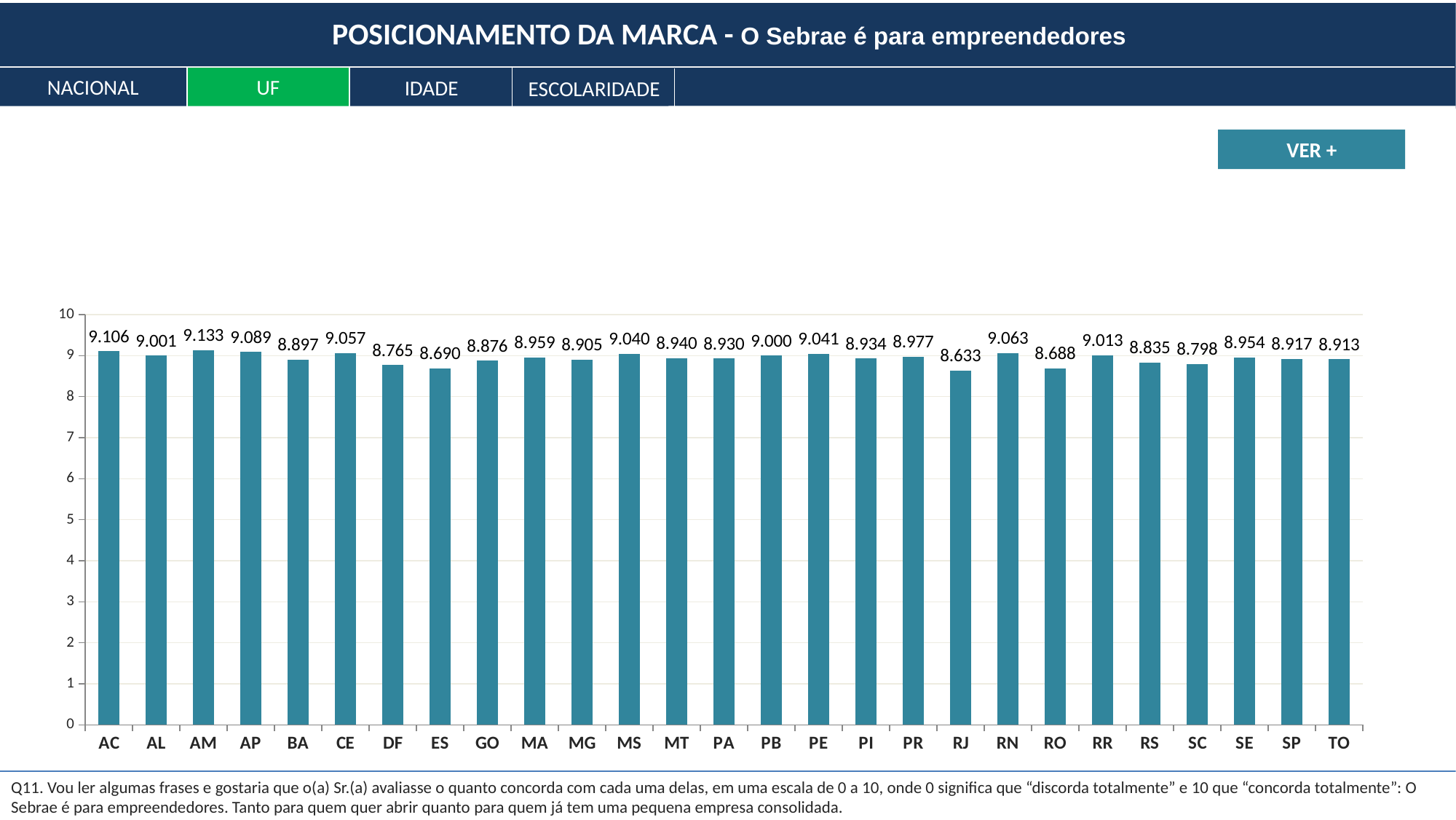
What kind of chart is shown on the slide? Bar chart What is the difference between the values for AM and RJ? 0.500 Which tab is highlighted in green at the top of the slide? UF What is the value for PB? 9.000 How many UFs (bars) are shown in the chart? 27 Which UF has the highest value? AM Which has a larger value, CE or ES? CE Which UF has the lowest value? RJ What is the value for SP? 8.917 What is the value for RJ? 8.633 What is the difference between the values for AC and AL? 0.105 What is the value for AC? 9.106